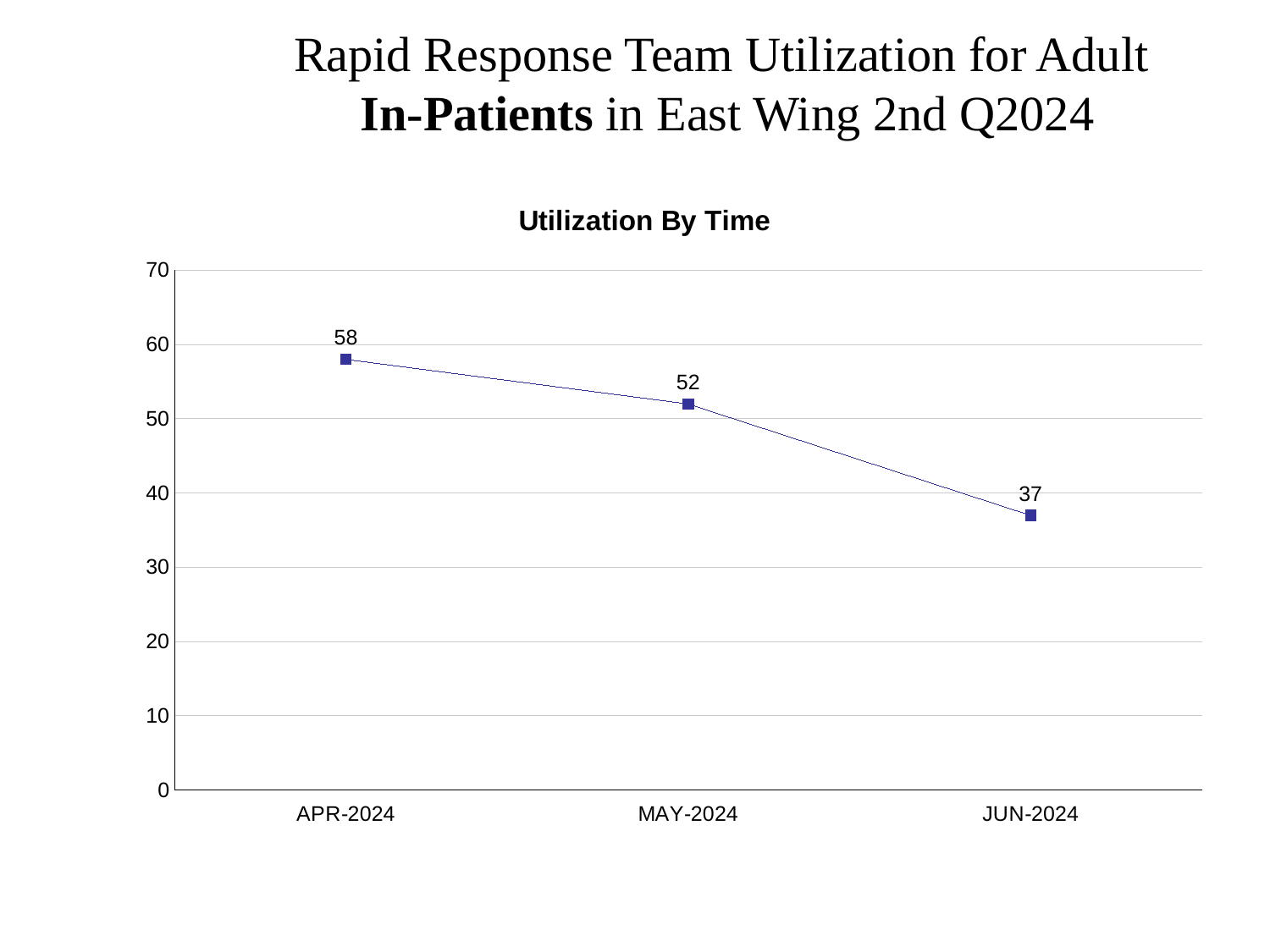
What is the value for JUN-2024? 37 Which month has the lowest value? JUN-2024 Do the values rise or fall from APR-2024 to JUN-2024? fall How many data points are plotted on the chart? 3 What is the difference between the values for MAY-2024 and JUN-2024? 15 What kind of chart is shown on the slide? line chart Is the value for JUN-2024 greater or less than 40? less What is the value for APR-2024? 58 What is the value for MAY-2024? 52 What is the difference between the values for APR-2024 and JUN-2024? 21 Which month has the highest value? APR-2024 Which is larger, the value for APR-2024 or the value for MAY-2024? APR-2024